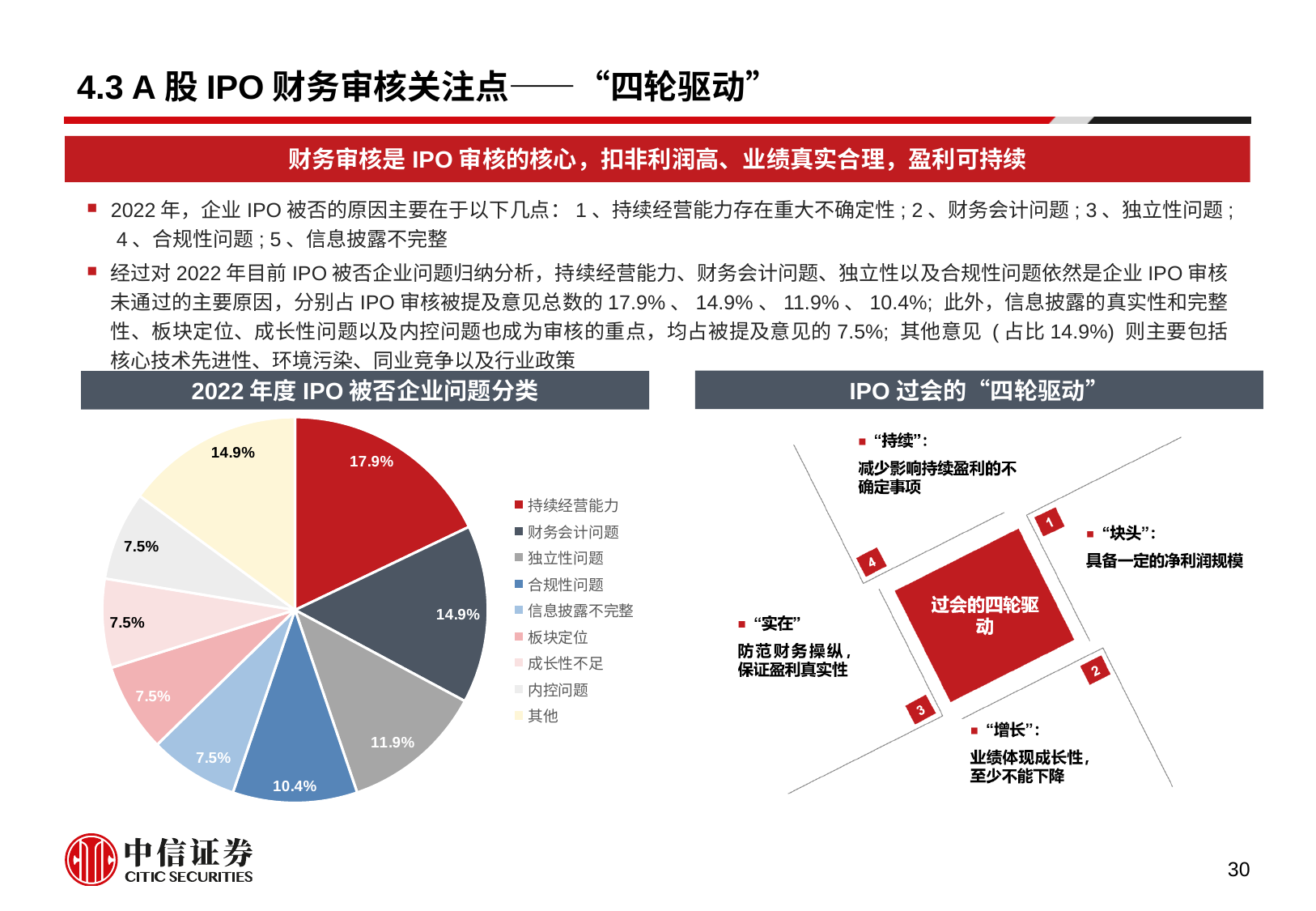
What share of the pie does 其他 account for? 14.9% What is the value shown for 合规性问题 in the pie chart? 10.4% Which is larger in the pie chart, 独立性问题 or 板块定位? 独立性问题 What is the title of the pie chart? 2022 年度 IPO 被否企业问题分类 What share of the pie does 持续经营能力 account for? 17.9% What kind of chart is shown on the slide? pie chart What is the value shown for 财务会计问题 in the pie chart? 14.9% What is the value shown for 独立性问题 in the pie chart? 11.9% What colour is the slice for 持续经营能力 in the pie chart? red Which category has the largest slice in the pie chart? 持续经营能力 How many categories does the legend of the pie chart list? 9 What is the difference between the shares of 持续经营能力 and 合规性问题? 7.5%